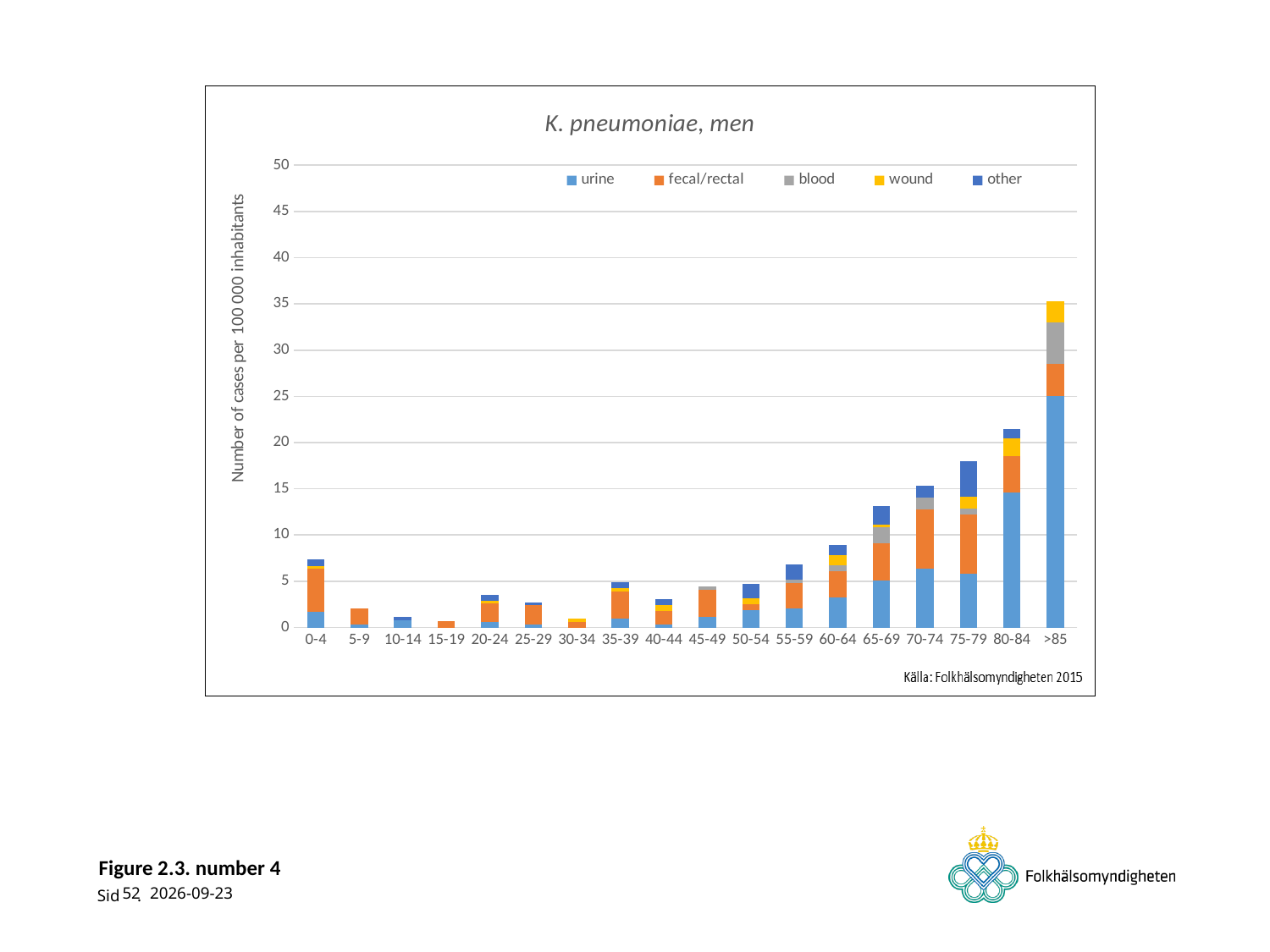
Is the total value for the 65-69 age group greater or less than 15? less Which age group has the highest total number of cases per 100 000 inhabitants? >85 How many age groups are shown on the x axis? 18 How many series does the legend list? 5 Is the total value for the 0-4 age group greater or less than 5? greater What kind of chart is shown on the slide? stacked bar chart What is the title of the chart? K. pneumoniae, men Do the total values rise or fall from the 50-54 age group to the >85 age group? rise What is the label of the y axis? Number of cases per 100 000 inhabitants Is the total value for the >85 age group greater or less than 30? greater Which age group has the larger total, 80-84 or 75-79? 80-84 Which age group has the larger total, 0-4 or 5-9? 0-4